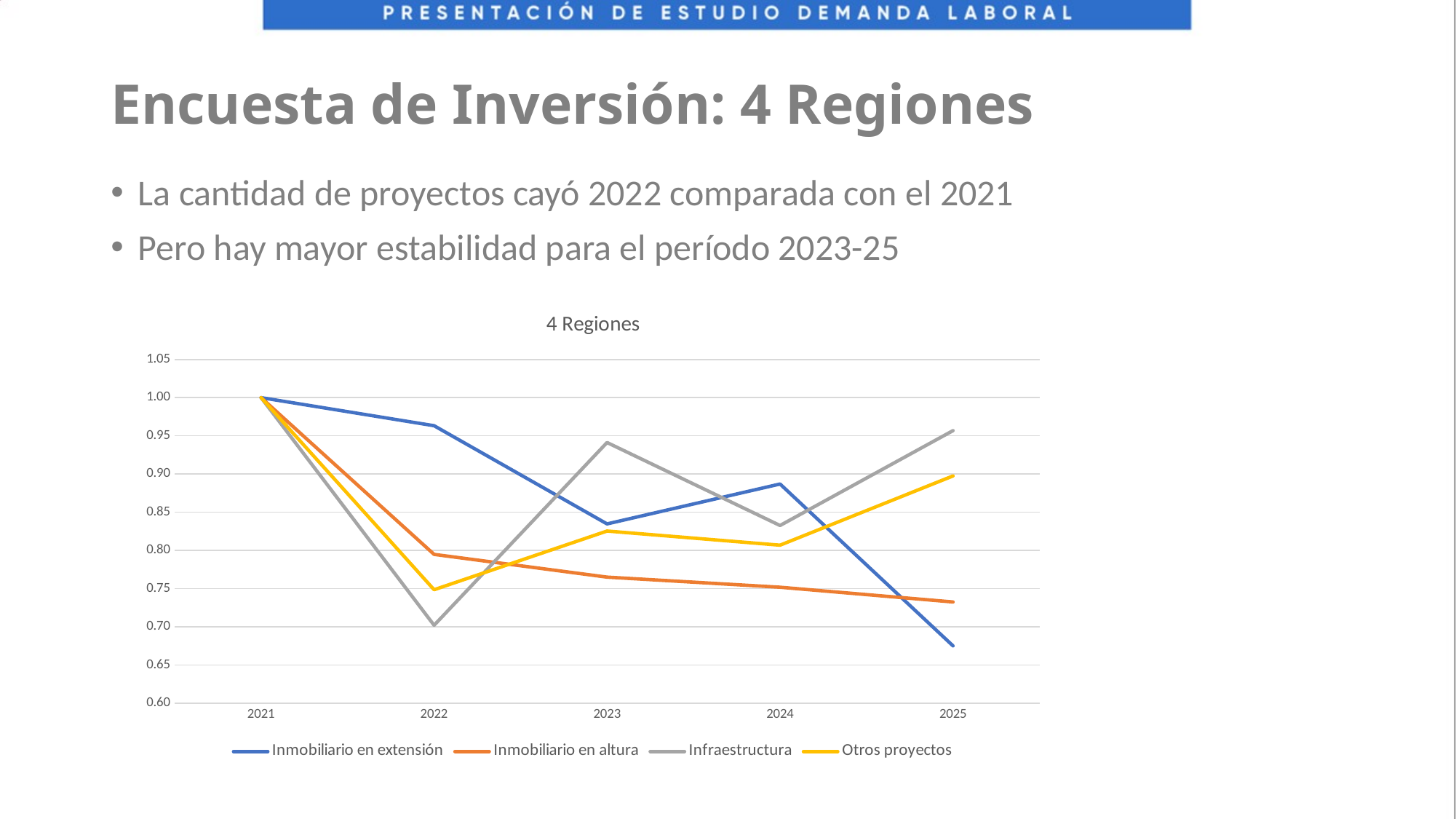
Is the value for Infraestructura in 2025 greater or less than 0.90? greater What is the value for Infraestructura in 2021? 1.00 What is the title of the chart? 4 Regiones Which series has the lowest value in 2022? Infraestructura Which series has the highest value in 2025? Infraestructura How many years are shown on the x axis of the chart? 5 What kind of chart is shown on the slide? line chart Which series has the highest value in 2023? Infraestructura Does the Inmobiliario en altura series rise or fall from 2021 to 2025? fall Which series has the lowest value in 2025? Inmobiliario en extensión How many series does the chart legend list? 4 Is the value for Inmobiliario en extensión in 2025 greater or less than 0.70? less